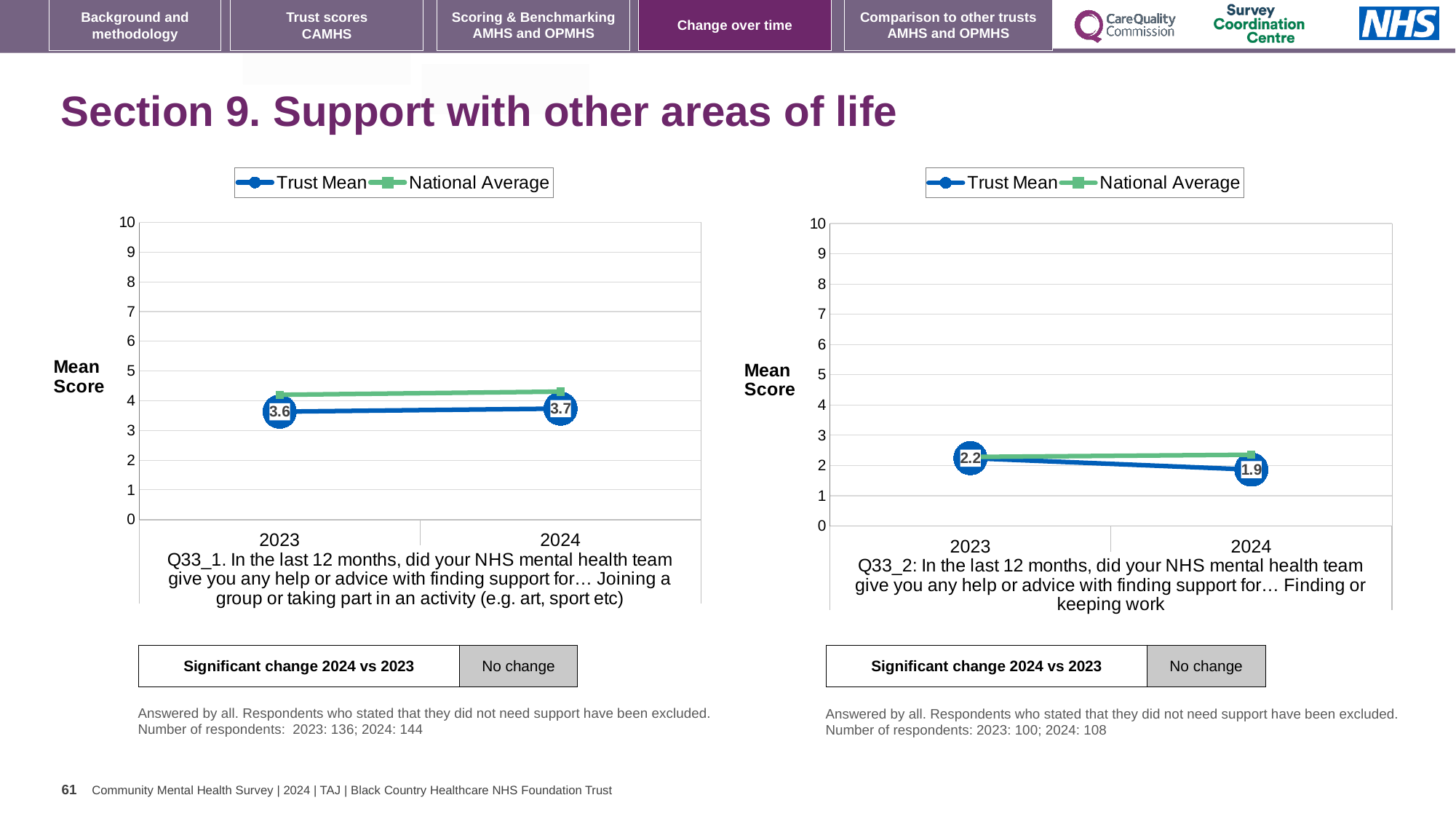
In the left chart (Q33_1), what is the Trust Mean for 2024? 3.7 In the right chart (Q33_2), what is the Trust Mean for 2024? 1.9 In the left chart (Q33_1), which is higher in 2024, the Trust Mean or the National Average? National Average In the left chart (Q33_1), what is the Trust Mean for 2023? 3.6 In the left chart (Q33_1), does the Trust Mean rise or fall from 2023 to 2024? rise In the right chart (Q33_2), what is the Trust Mean for 2023? 2.2 How many series does the legend of the right chart (Q33_2) list? 2 What kind of chart is the left chart (Q33_1)? line chart In the right chart (Q33_2), does the Trust Mean rise or fall from 2023 to 2024? fall In the left chart (Q33_1), is the National Average for 2024 greater or less than 5? less How many years are plotted on the x axis of the left chart (Q33_1)? 2 In the right chart (Q33_2), what is the difference between the Trust Mean for 2023 and 2024? 0.3